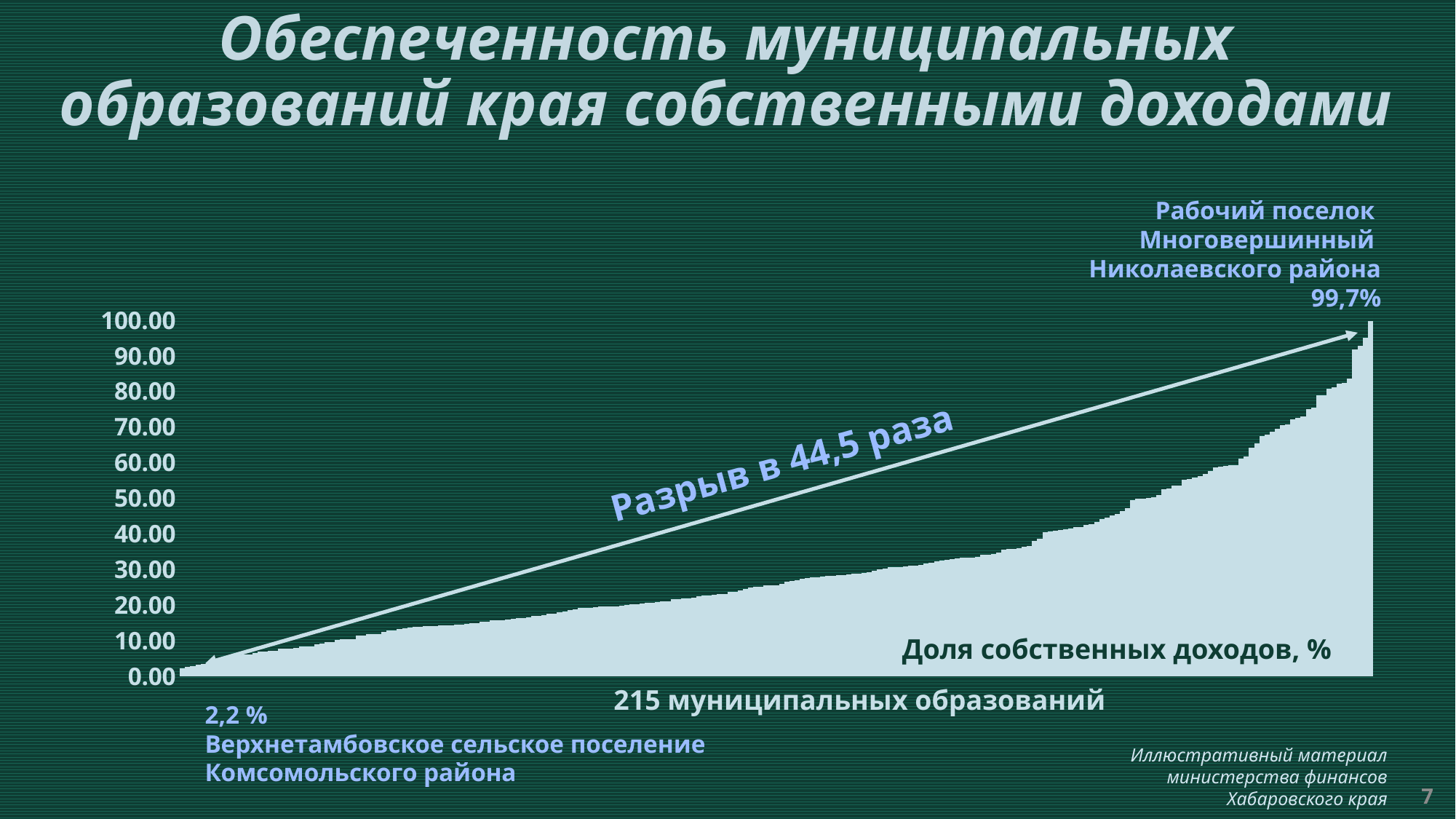
Which municipality has the highest share of own revenues on the chart? Рабочий поселок Многовершинный Николаевского района How many municipalities are plotted on the chart? 215 What is the highest tick value shown on the vertical axis? 100.00 According to the annotation on the chart, how many times larger is the highest value than the lowest (the 'разрыв')? 44,5 раза Which is larger: the share for Рабочий поселок Многовершинный or the share for Верхнетамбовское сельское поселение? Рабочий поселок Многовершинный What kind of chart is shown on the slide? Bar chart What is the difference in percentage points between the highest value (99,7%) and the lowest value (2,2 %)? 97,5 Do the values rise or fall from left to right along the x axis? Rise What is the share of own revenues for Верхнетамбовское сельское поселение Комсомольского района? 2,2 % Which municipality has the lowest share of own revenues on the chart? Верхнетамбовское сельское поселение Комсомольского района What is the share of own revenues for Рабочий поселок Многовершинный Николаевского района? 99,7%